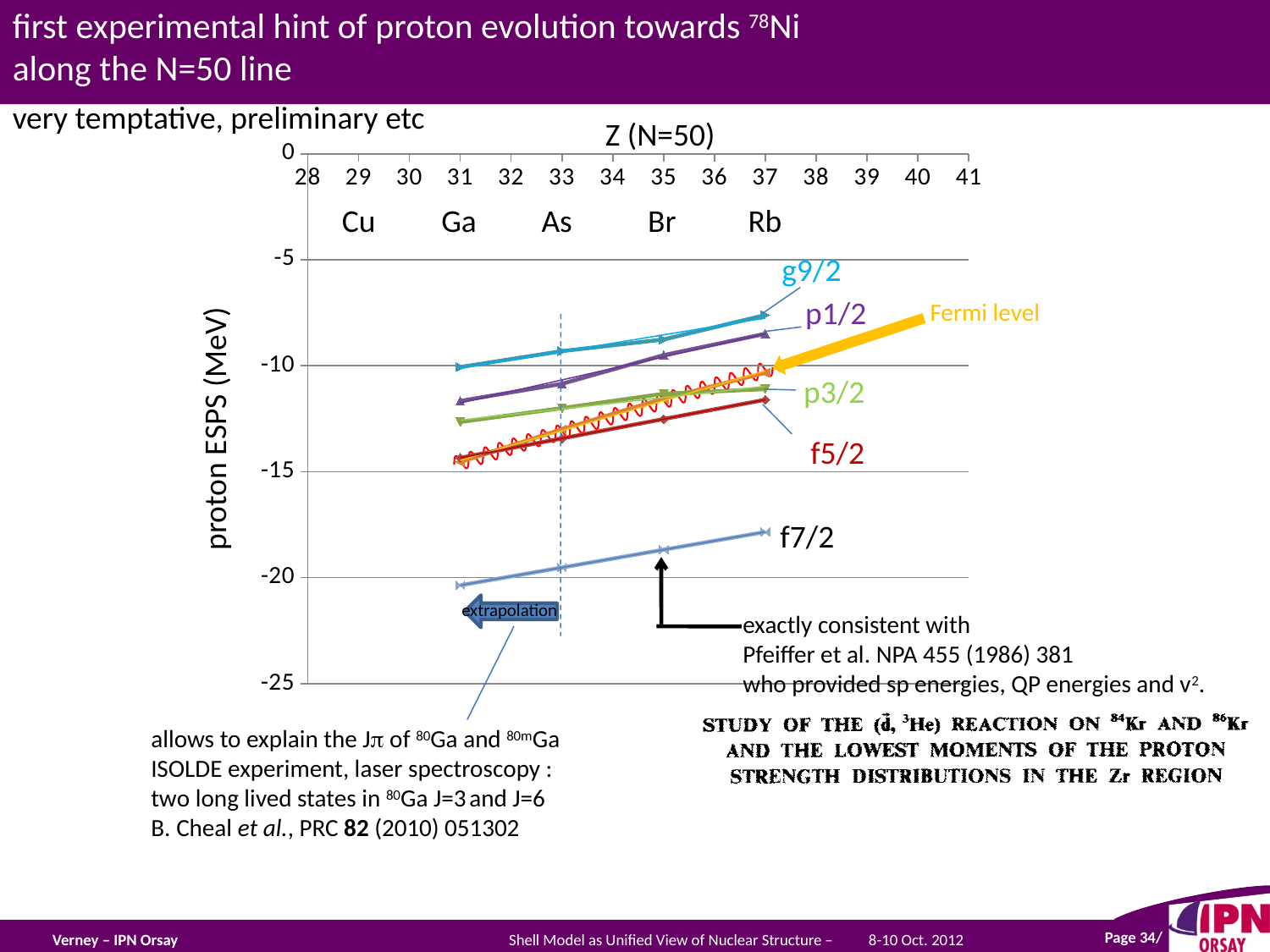
What kind of chart is shown on the slide? line chart Is the value of f5/2 at Z=31 greater or less than -15? greater At Z=37, which is larger, the value of g9/2 or the value of f7/2? g9/2 What is the title of the vertical axis? proton ESPS (MeV) Do the proton ESPS values of the orbitals rise or fall as Z increases from 31 to 37? rise Is the value of p1/2 at Z=31 greater or less than -10? less Is the value of f7/2 at Z=31 greater or less than -20? less Which orbital has the highest (least negative) proton ESPS across the plotted Z range? g9/2 What is the title of the horizontal axis? Z (N=50) Which orbital has the lowest (most negative) proton ESPS across the plotted Z range? f7/2 How many orbital series (g9/2, p1/2, p3/2, f5/2, f7/2) are labelled on the chart? 5